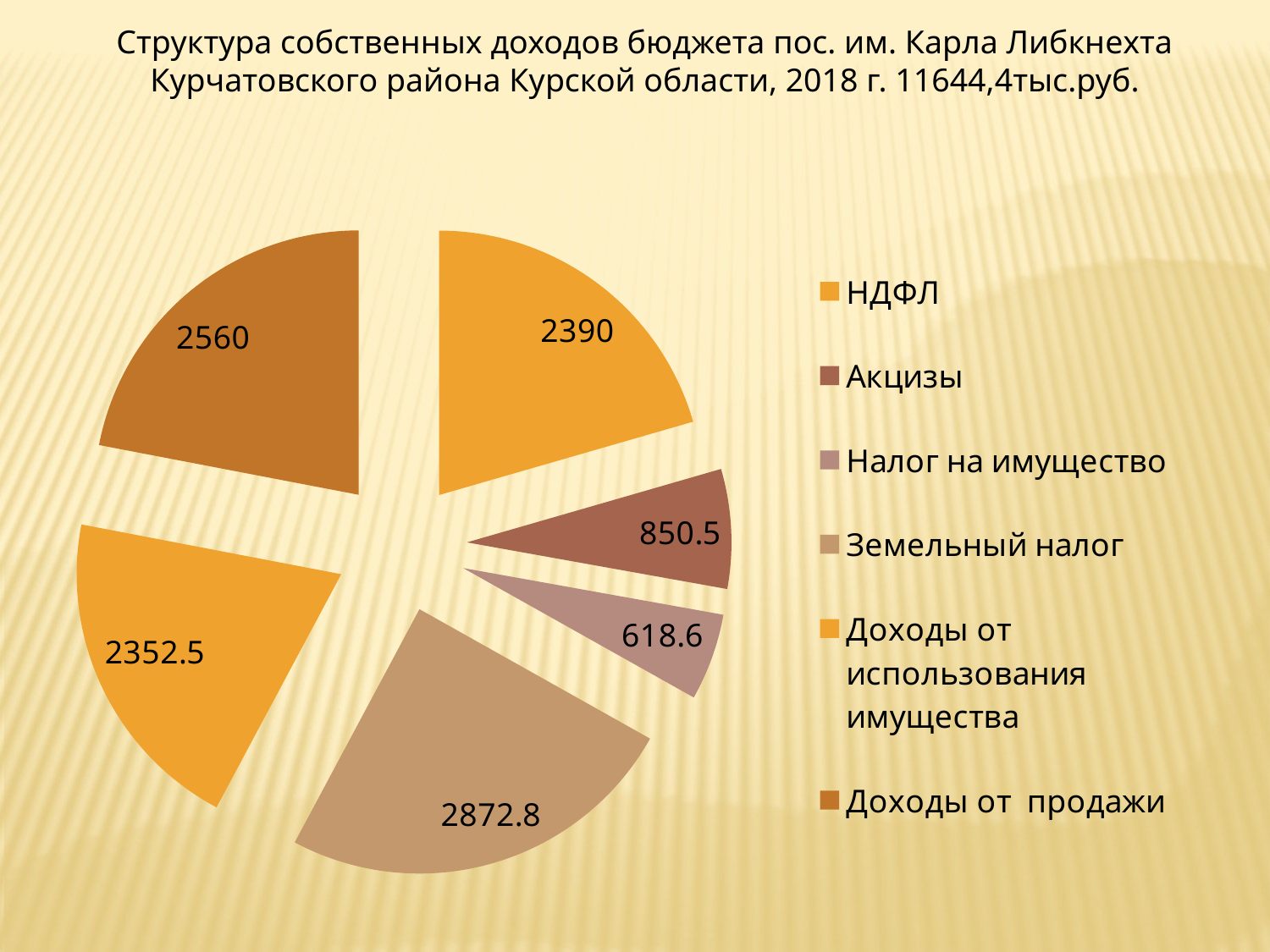
Which category has the largest slice of the pie? Земельный налог What is the difference between the values for Акцизы and Налог на имущество? 231.9 How many categories does the legend list? 6 What is the value for Доходы от продажи? 2560 What is the difference between the values for Земельный налог and Доходы от продажи? 312.8 Which is larger, the value for Доходы от продажи or the value for НДФЛ? Доходы от продажи What is the value for Земельный налог? 2872.8 What is the value for Доходы от использования имущества? 2352.5 What is the value for НДФЛ? 2390 What type of chart is shown on the slide? pie chart What is the value for Акцизы? 850.5 Which category has the smallest slice of the pie? Налог на имущество